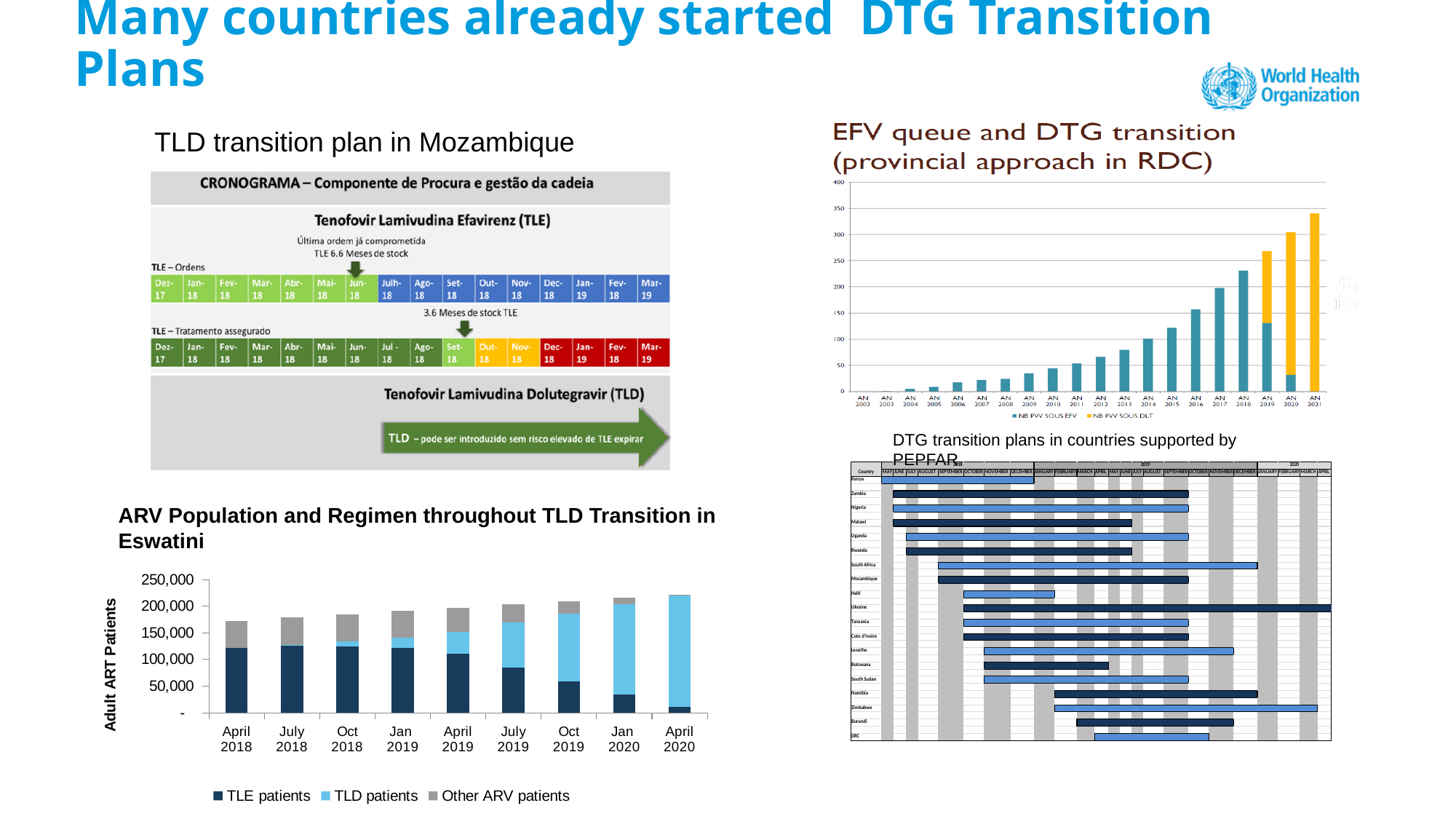
In the 'EFV queue and DTG transition (provincial approach in RDC)' chart, is the NB PVV SOUS DLT value for AN 2021 greater or less than 300? greater In the 'ARV Population and Regimen throughout TLD Transition in Eswatini' chart, is the TLE patients value for April 2018 greater or less than 100,000? greater In the 'EFV queue and DTG transition (provincial approach in RDC)' chart, do the NB PVV SOUS EFV values rise or fall from AN 2002 to AN 2018? Rise In the 'EFV queue and DTG transition (provincial approach in RDC)' chart, how many series does the legend list? 2 In the 'ARV Population and Regimen throughout TLD Transition in Eswatini' chart, what kind of chart is shown? Stacked bar chart In the 'ARV Population and Regimen throughout TLD Transition in Eswatini' chart, what is the y-axis label? Adult ART Patients In the 'ARV Population and Regimen throughout TLD Transition in Eswatini' chart, is the TLE patients value for April 2020 greater or less than 50,000? less In the 'ARV Population and Regimen throughout TLD Transition in Eswatini' chart, how many time points are shown on the x axis? 9 In the 'ARV Population and Regimen throughout TLD Transition in Eswatini' chart, how many series does the legend list? 3 In the 'ARV Population and Regimen throughout TLD Transition in Eswatini' chart, which series is shown in light blue? TLD patients In the 'EFV queue and DTG transition (provincial approach in RDC)' chart, which year has the tallest bar? AN 2021 In the 'ARV Population and Regimen throughout TLD Transition in Eswatini' chart, do the TLE patients values rise or fall from April 2018 to April 2020? Fall